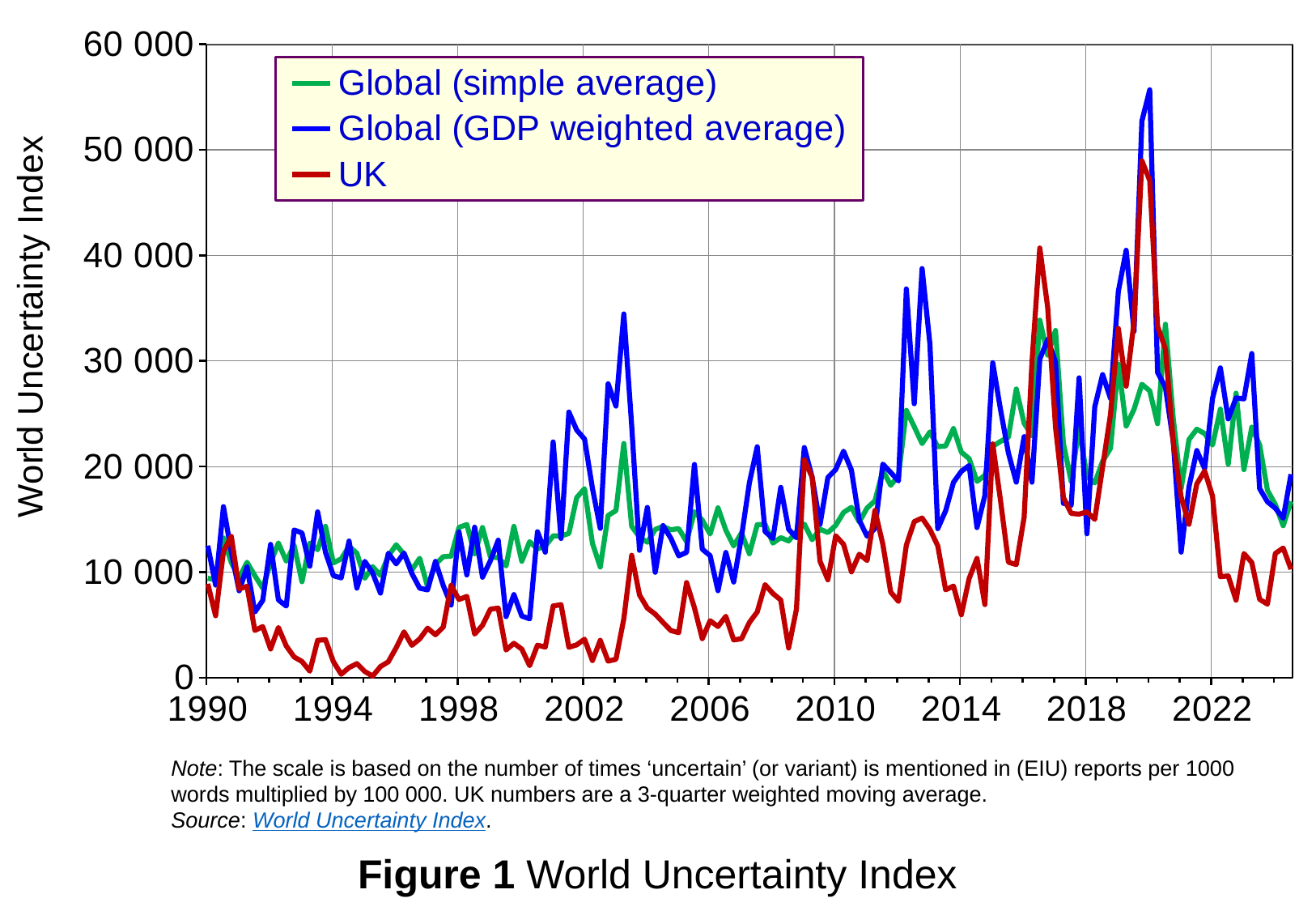
Is the Global (simple average) value in 1990 greater or less than 20 000? less Around 1995, which is higher: the UK series or the Global (simple average) series? Global (simple average) How many series does the legend list? 3 Is the UK value around 1995 greater or less than 10 000? less What is the title of the figure? Figure 1 World Uncertainty Index Which series reaches the highest value anywhere on the chart? Global (GDP weighted average) Is the peak of the Global (GDP weighted average) series around 2020 greater or less than 50 000? greater Does the UK series rise or fall between its 2020 peak and 2022? fall Which series is drawn in red? UK What kind of chart is shown in Figure 1? Line chart